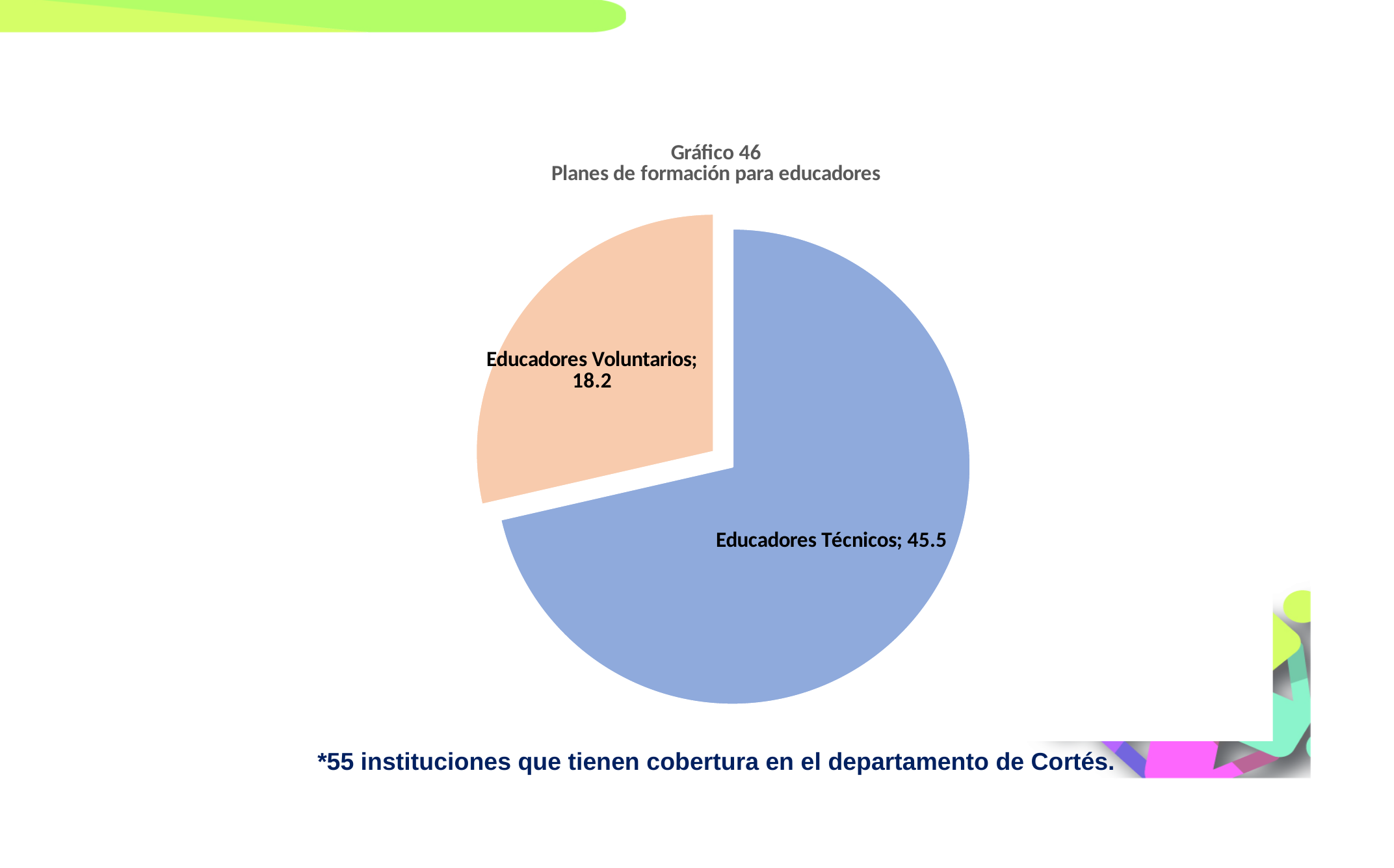
Which is larger, the value for Educadores Voluntarios or the value for Educadores Técnicos? Educadores Técnicos Which category has the largest slice of the pie? Educadores Técnicos What colour is the slice for Educadores Técnicos? Blue What is the title of the chart? Gráfico 46 Planes de formación para educadores What kind of chart is shown on the slide? Pie chart What is the sum of the two values shown in the pie chart? 63.7 What is the difference between the values for Educadores Técnicos and Educadores Voluntarios? 27.3 What is the value shown for Educadores Voluntarios? 18.2 How many slices does the pie chart have? 2 What is the value shown for Educadores Técnicos? 45.5 Which category has the smallest slice of the pie? Educadores Voluntarios